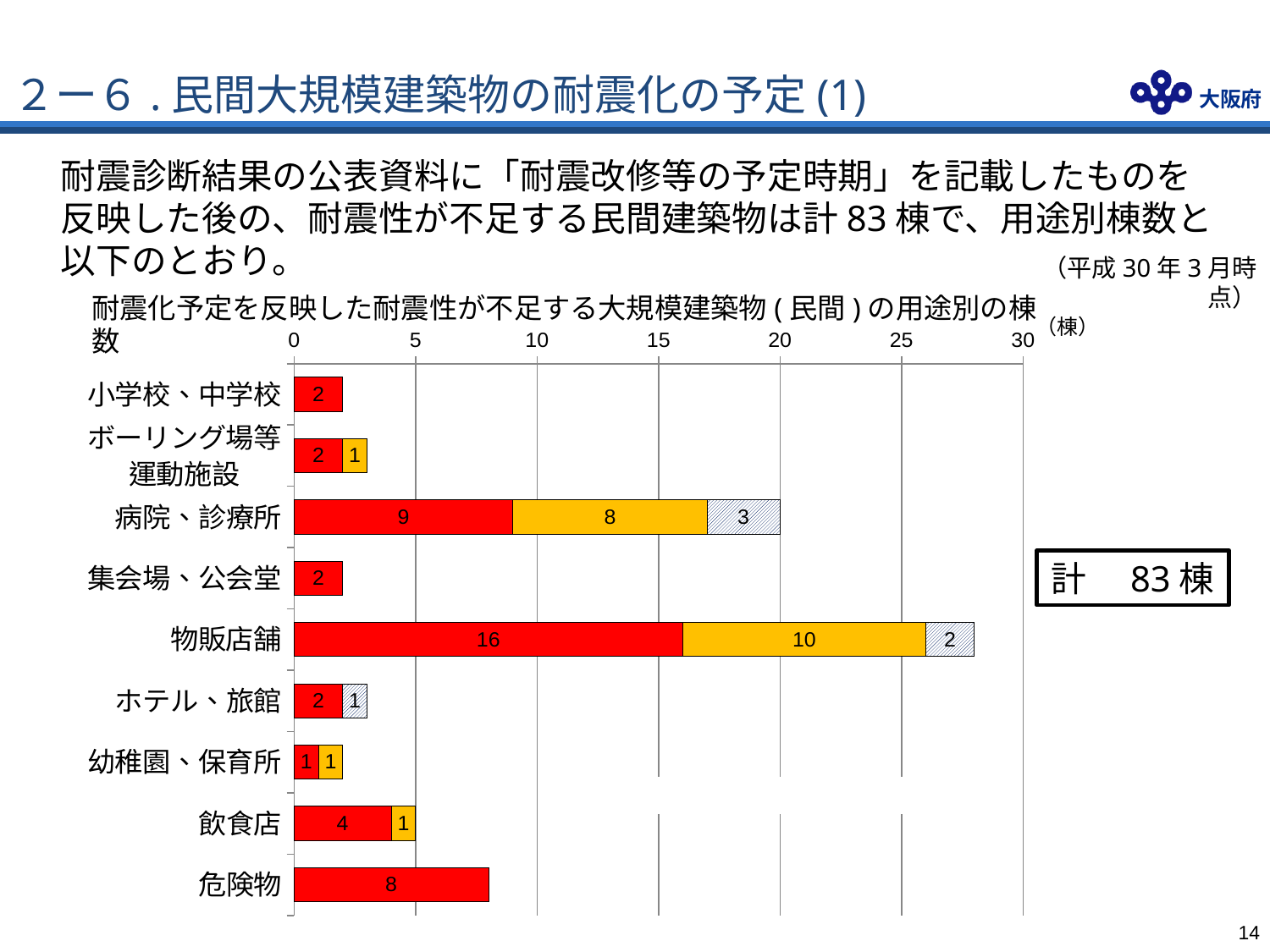
Which is larger: the total bar for 飲食店 or the total bar for 危険物? 危険物 What is the value of the red segment for 物販店舗? 16 How many building-use categories are plotted on the chart? 9 What is the value of the orange segment for 病院、診療所? 8 Which category has the longest total bar? 物販店舗 What is the total of the stacked bar for 物販店舗? 28 What is the difference between the red segment of 物販店舗 and the red segment of 病院、診療所? 7 What is the value of the hatched segment for 病院、診療所? 3 What is the value shown for 危険物? 8 What type of chart is shown on the slide? stacked bar chart Is the total bar for 物販店舗 greater or less than 25? greater What is the total of the stacked bar for 病院、診療所? 20